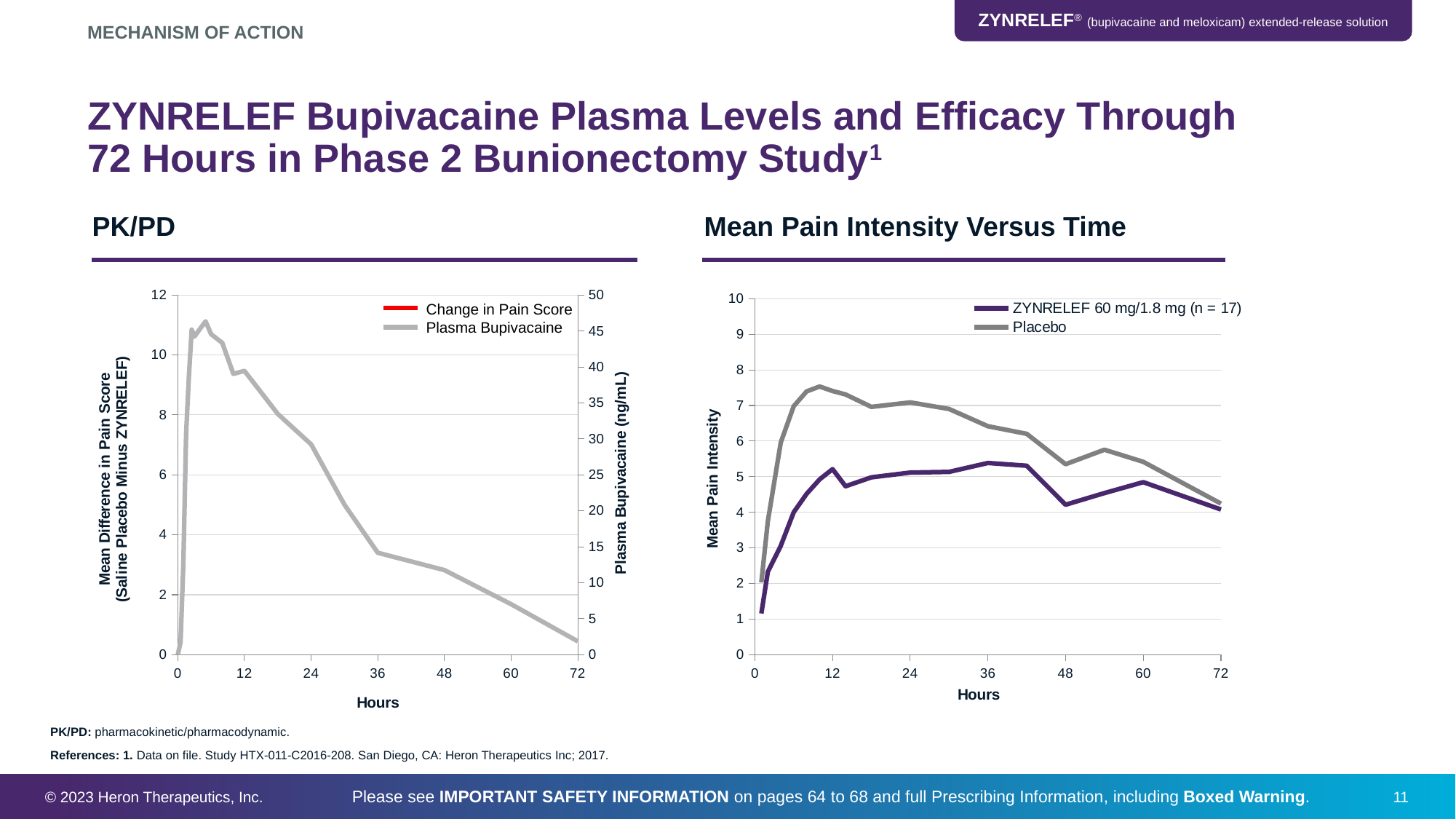
How many series does the legend of the PK/PD chart list? 2 In the Mean Pain Intensity Versus Time chart, is the Placebo value at 12 hours greater or less than 7? greater In the Mean Pain Intensity Versus Time chart, which series has the higher mean pain intensity at 12 hours, ZYNRELEF 60 mg/1.8 mg or Placebo? Placebo What is the title of the right-hand axis of the PK/PD chart? Plasma Bupivacaine (ng/mL) In the PK/PD chart, is the peak Plasma Bupivacaine value greater or less than 40 ng/mL? greater In the Mean Pain Intensity Versus Time chart, is the ZYNRELEF 60 mg/1.8 mg value at 48 hours greater or less than 5? less What kind of chart is the PK/PD chart on the left? line chart In the PK/PD chart, does the Plasma Bupivacaine line rise or fall between 12 and 72 hours? fall What kind of chart is the Mean Pain Intensity Versus Time chart on the right? line chart What is the x-axis title of the Mean Pain Intensity Versus Time chart? Hours How many series does the legend of the Mean Pain Intensity Versus Time chart list? 2